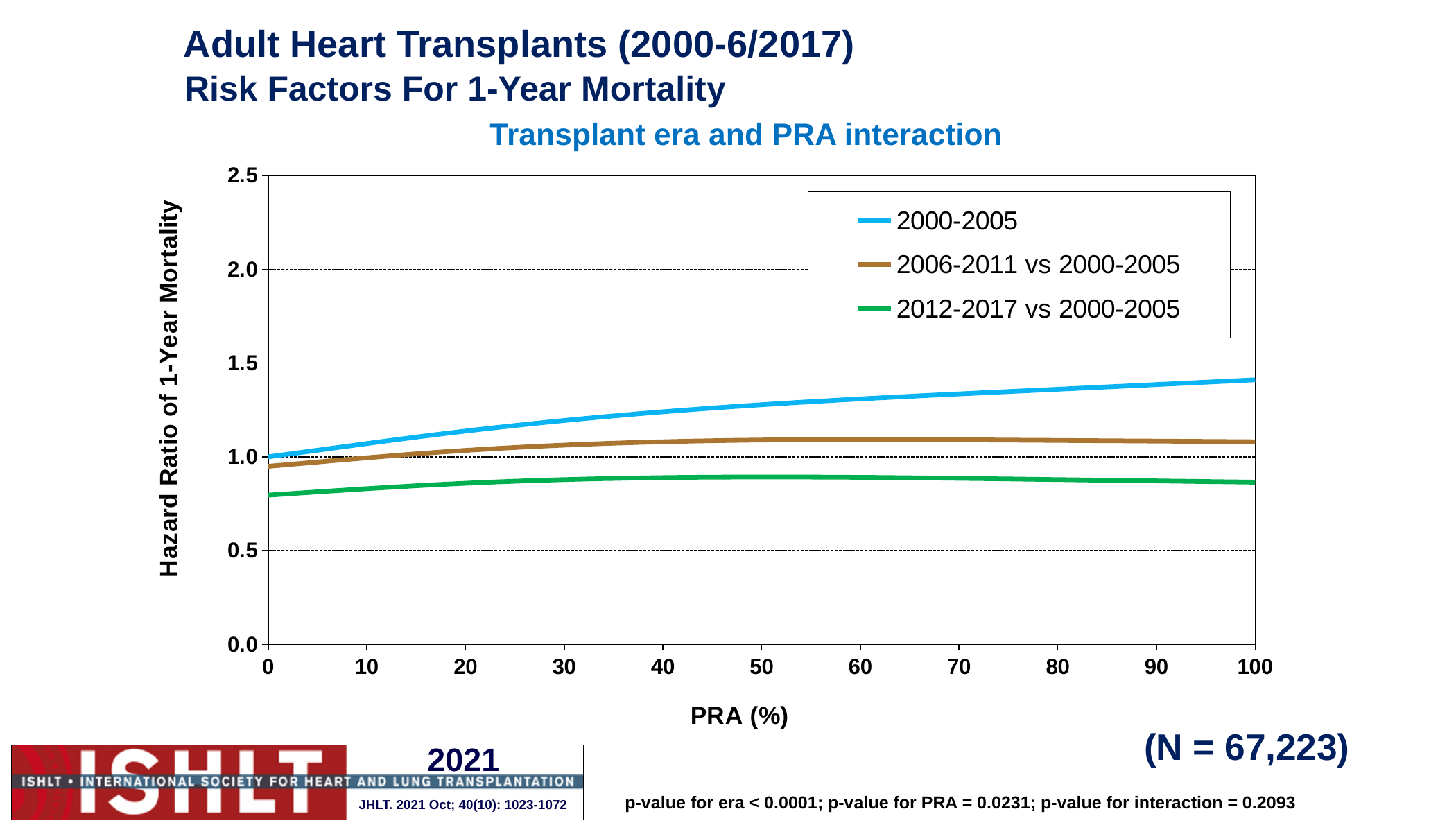
What kind of chart is shown on the slide? line chart At PRA 100%, which series has the larger hazard ratio: 2006-2011 vs 2000-2005 or 2012-2017 vs 2000-2005? 2006-2011 vs 2000-2005 Which series has the highest hazard ratio at PRA 100%? 2000-2005 Which series is shown in green in the legend? 2012-2017 vs 2000-2005 Is the hazard ratio for 2000-2005 at PRA 100% greater or less than 1.0? greater What is the title of the chart? Transplant era and PRA interaction Is the hazard ratio for 2012-2017 vs 2000-2005 at PRA 100% greater or less than 0.5? greater Is the hazard ratio for 2000-2005 at PRA 100% greater or less than 1.5? less Does the 2000-2005 line rise or fall as PRA increases from 0 to 100? rise Which series has the lowest hazard ratio at PRA 50%? 2012-2017 vs 2000-2005 How many series does the legend list? 3